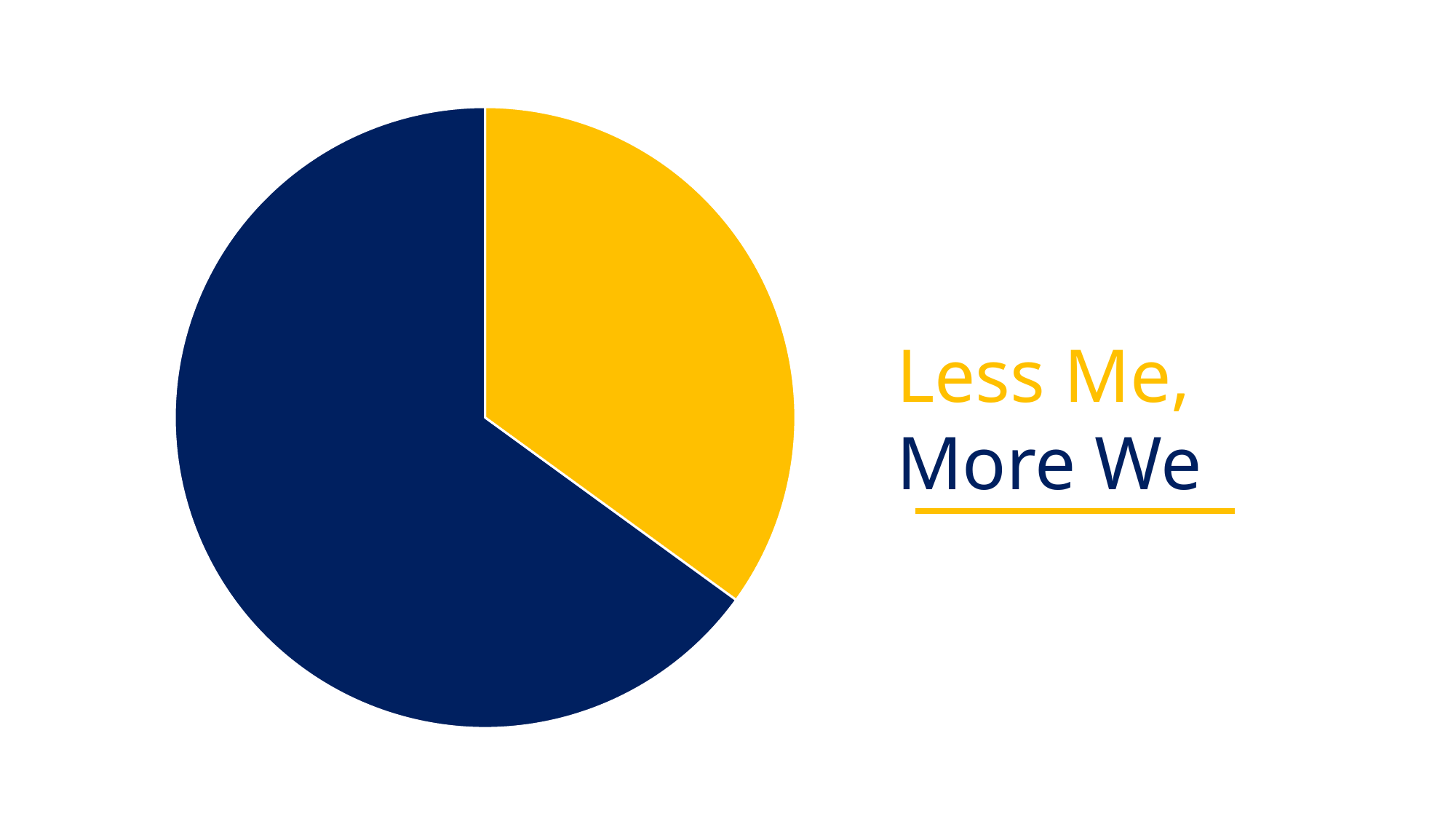
Which slice of the pie chart is the largest? the dark navy slice What two colours are used for the slices of the pie chart? dark navy and yellow Does the yellow slice take up more or less than half of the pie chart? less Which slice of the pie chart is larger, the dark navy slice or the yellow slice? the dark navy slice What text appears to the right of the pie chart? Less Me, More We Which slice of the pie chart is the smallest? the yellow slice What kind of chart is shown on the slide? pie chart Does the dark navy slice take up more or less than half of the pie chart? more How many slices does the pie chart have? 2